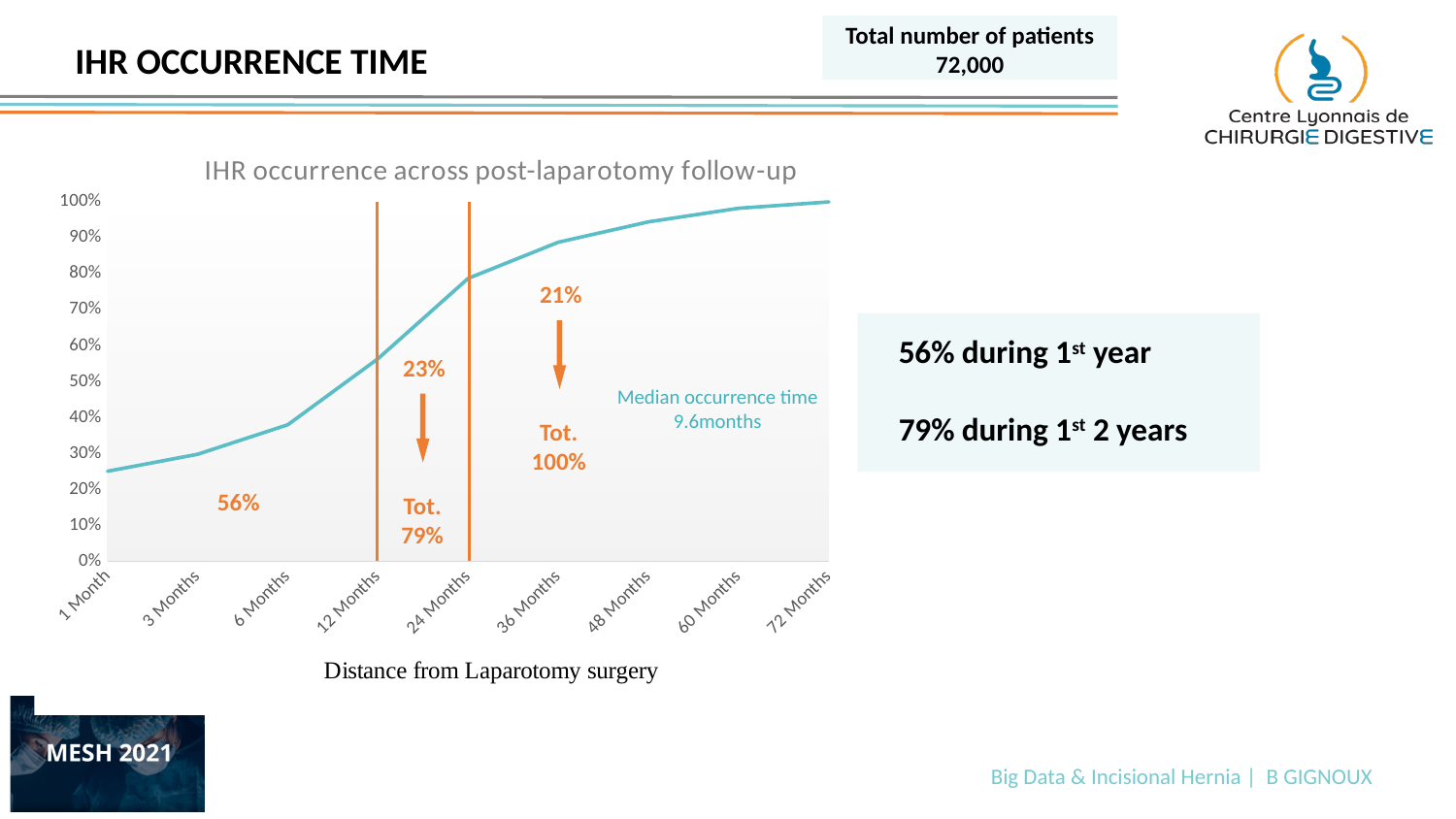
Is the IHR occurrence value at 1 Month greater or less than 20%? greater What is the title of the chart? IHR occurrence across post-laparotomy follow-up What median occurrence time is noted on the chart? 9.6months At which time point is the IHR occurrence value lowest? 1 Month At which time point is the IHR occurrence value highest? 72 Months How many time points are shown on the x axis of the chart? 9 According to the chart annotations, what cumulative percentage of IHR occurrences is reached by 24 months? 79% Does the IHR occurrence line rise or fall as the distance from laparotomy surgery increases? Rises According to the chart annotations, what percentage of IHR occurrences happen after 24 months? 21% What type of chart is shown on the slide? Line chart Is the IHR occurrence value at 36 Months greater or less than 80%? greater According to the chart annotations, what percentage of IHR occurrences happen between 12 and 24 months? 23%